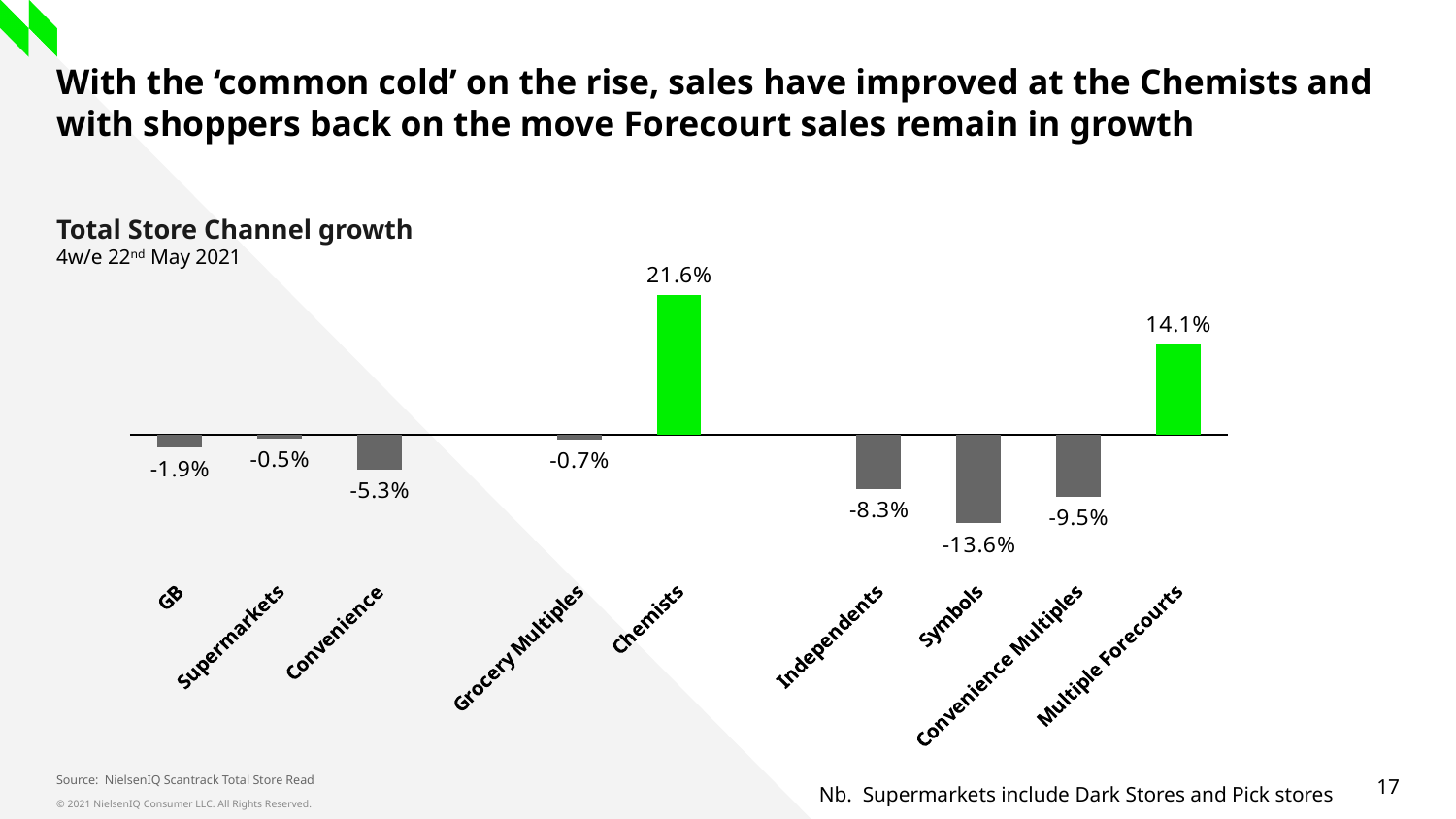
Which has a larger growth value, Independents or Convenience Multiples? Independents What is the title of the chart? Total Store Channel growth Which channel has the lowest growth? Symbols What kind of chart is shown on the slide? Bar chart What is the difference between the growth for Chemists and Multiple Forecourts? 7.5 percentage points Which channel has the highest growth? Chemists How many channels are shown in the chart? 9 What is the growth value for Convenience? -5.3% What period does the chart cover? 4w/e 22nd May 2021 What is the growth value for Multiple Forecourts? 14.1% What is the growth value for Symbols? -13.6% What is the growth value for Chemists? 21.6%